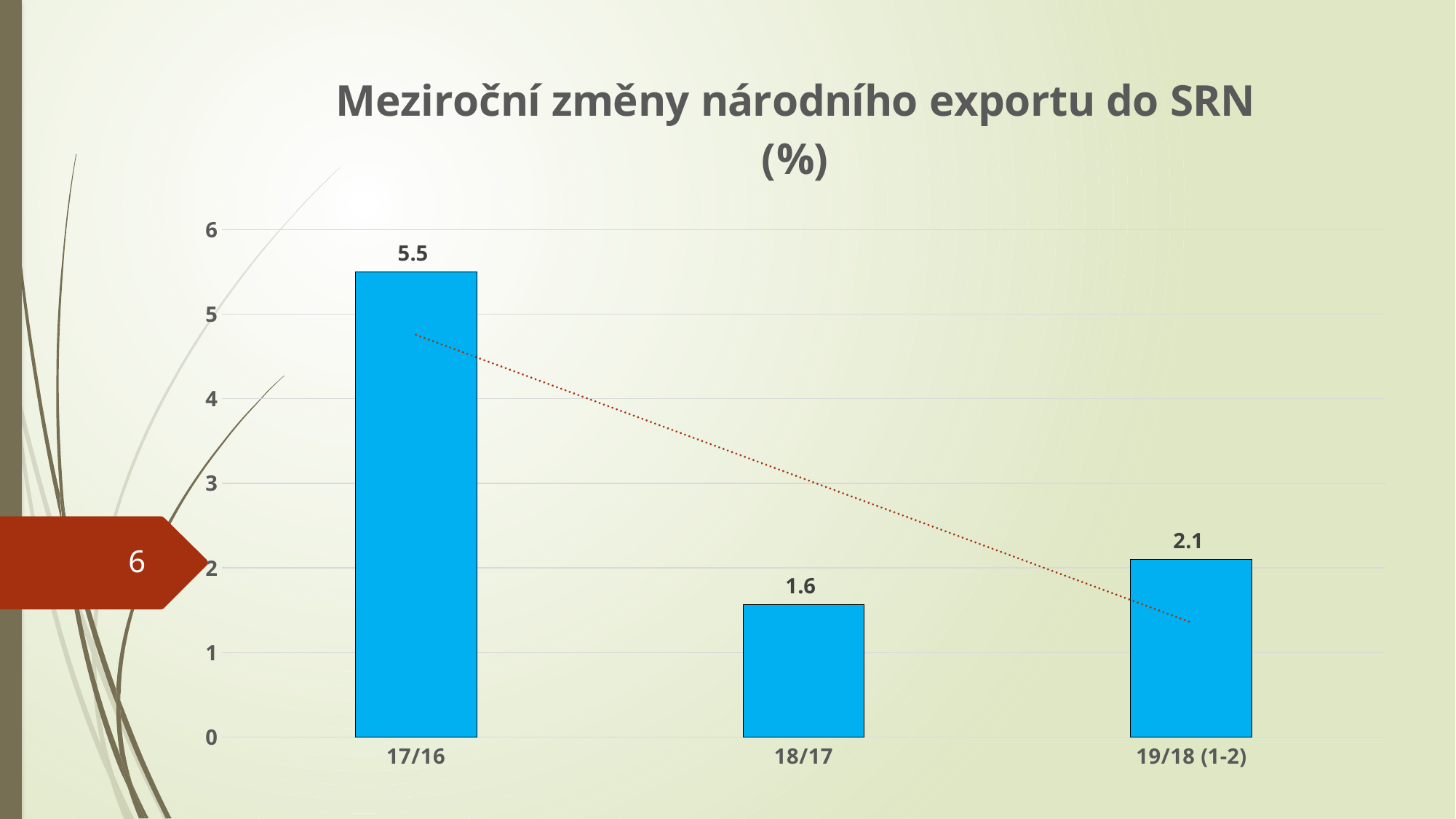
Which category has the lowest value? 18/17 What is the title of the chart? Meziroční změny národního exportu do SRN (%) What is the value for 17/16? 5.5 Is the value for 17/16 greater or less than 5? greater Which category has the highest value? 17/16 What is the value for 18/17? 1.6 What is the difference between the values for 19/18 (1-2) and 18/17? 0.5 What is the value for 19/18 (1-2)? 2.1 Which is larger, the value for 18/17 or the value for 19/18 (1-2)? 19/18 (1-2) How many categories are shown on the x axis? 3 What is the difference between the values for 17/16 and 18/17? 3.9 What kind of chart is shown on the slide? bar chart